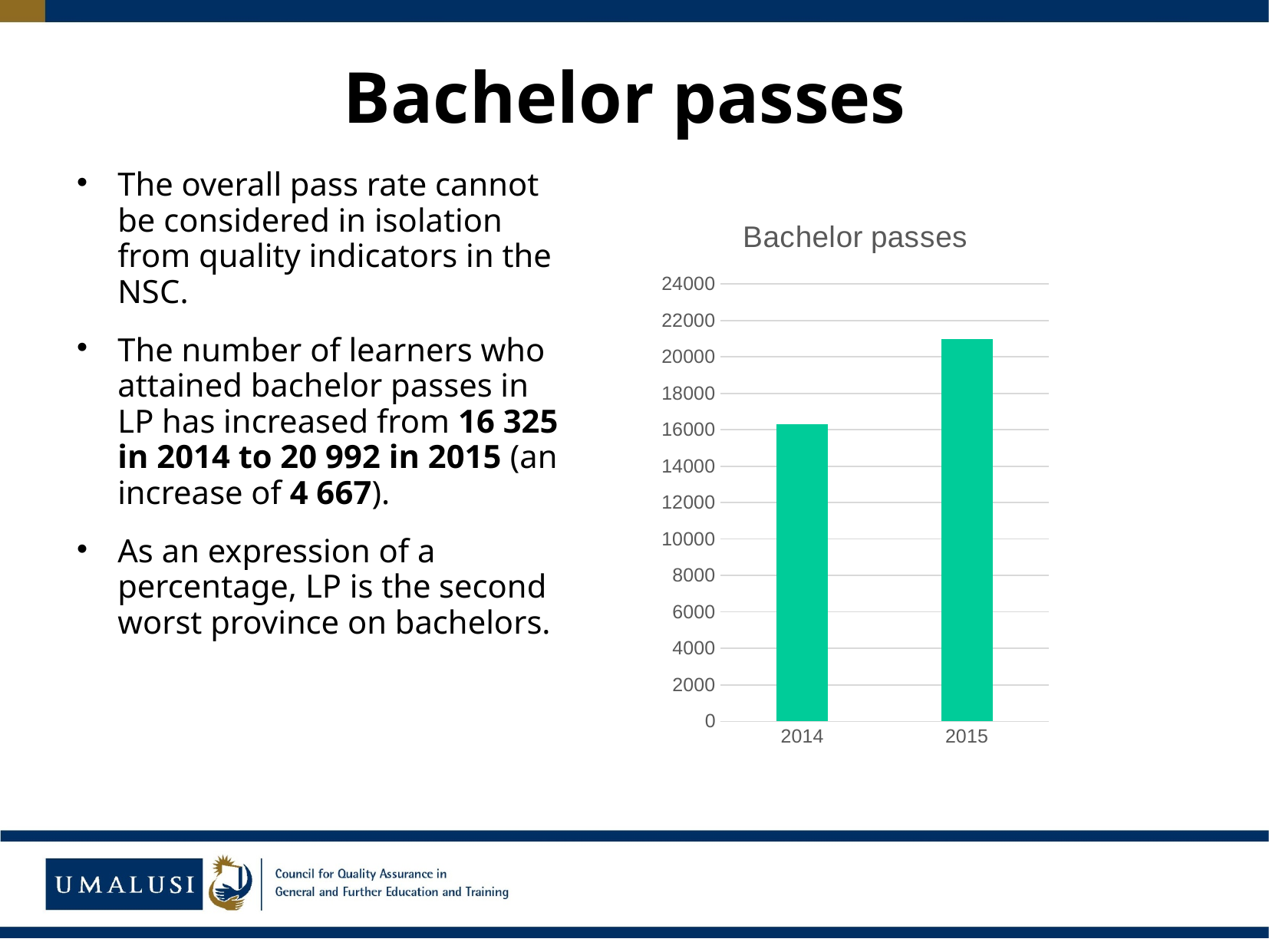
Do the values in the chart rise or fall from 2014 to 2015? rise Which year has the higher number of bachelor passes in the chart? 2015 Is the value for 2014 greater or less than 14000? greater Is the value for 2015 greater or less than 20000? greater Is the bar for 2015 taller or shorter than the bar for 2014? taller According to the slide, how many bachelor passes were attained in LP in 2014? 16 325 How many categories (years) are shown on the x axis of the chart? 2 What is the title of the chart? Bachelor passes According to the slide, by how much did the number of bachelor passes increase from 2014 to 2015? 4 667 Is the value for 2015 greater or less than 22000? less Which year has the lower number of bachelor passes in the chart? 2014 What type of chart is shown on the slide? bar chart